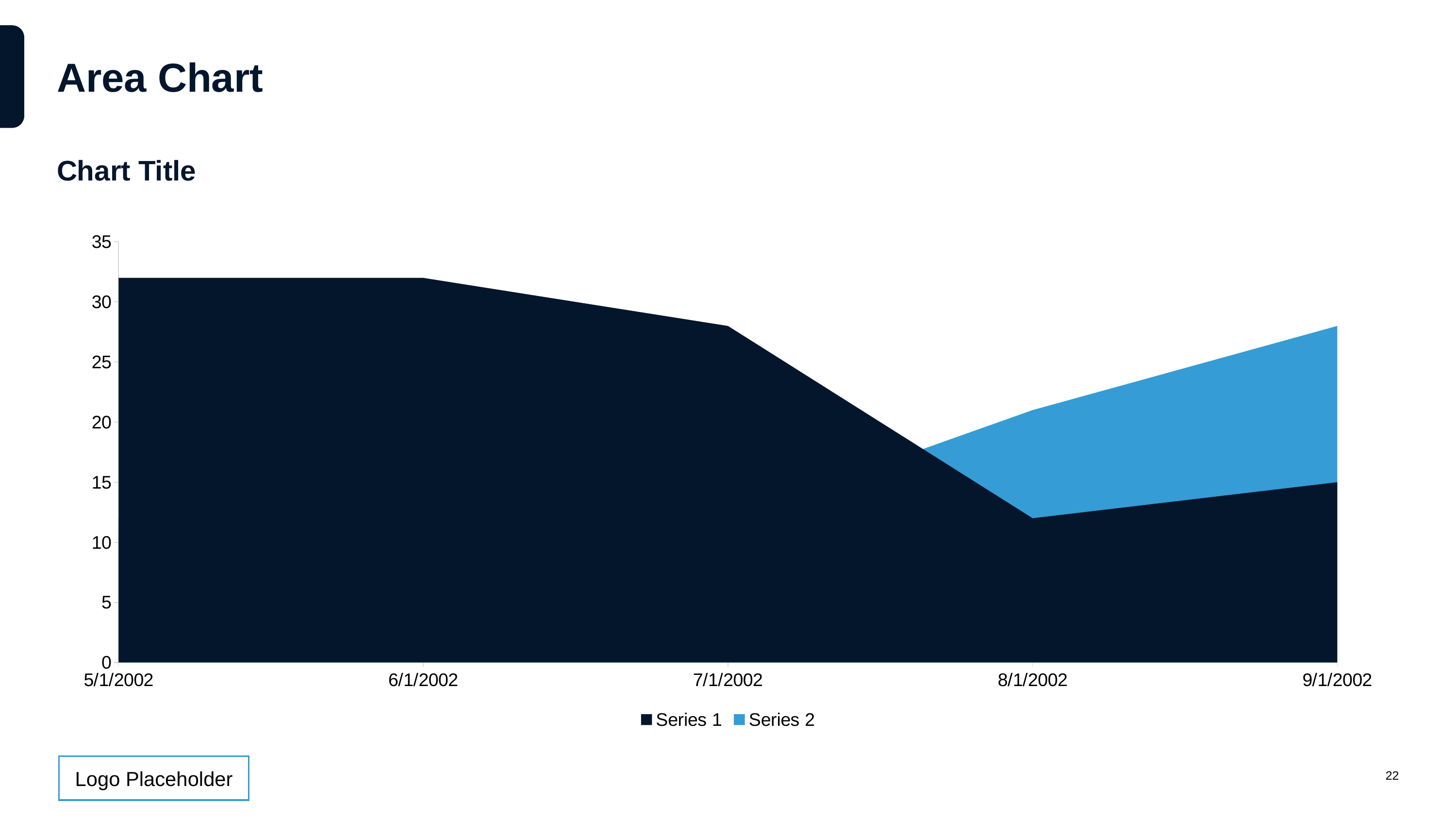
What is the title of the chart? Chart Title Which is larger for Series 1: the value at 5/1/2002 or the value at 8/1/2002? 5/1/2002 How many dates are shown on the x axis? 5 What kind of chart is shown on the slide? Area chart Is the value for Series 1 at 6/1/2002 greater or less than 30? greater Is the value for Series 1 at 7/1/2002 greater or less than 25? greater Which series is shown in light blue in the legend? Series 2 How many series does the legend list? 2 At which date is Series 1 lowest? 8/1/2002 Does Series 1 rise or fall between 6/1/2002 and 8/1/2002? fall Is the value for Series 1 at 5/1/2002 greater or less than 30? greater